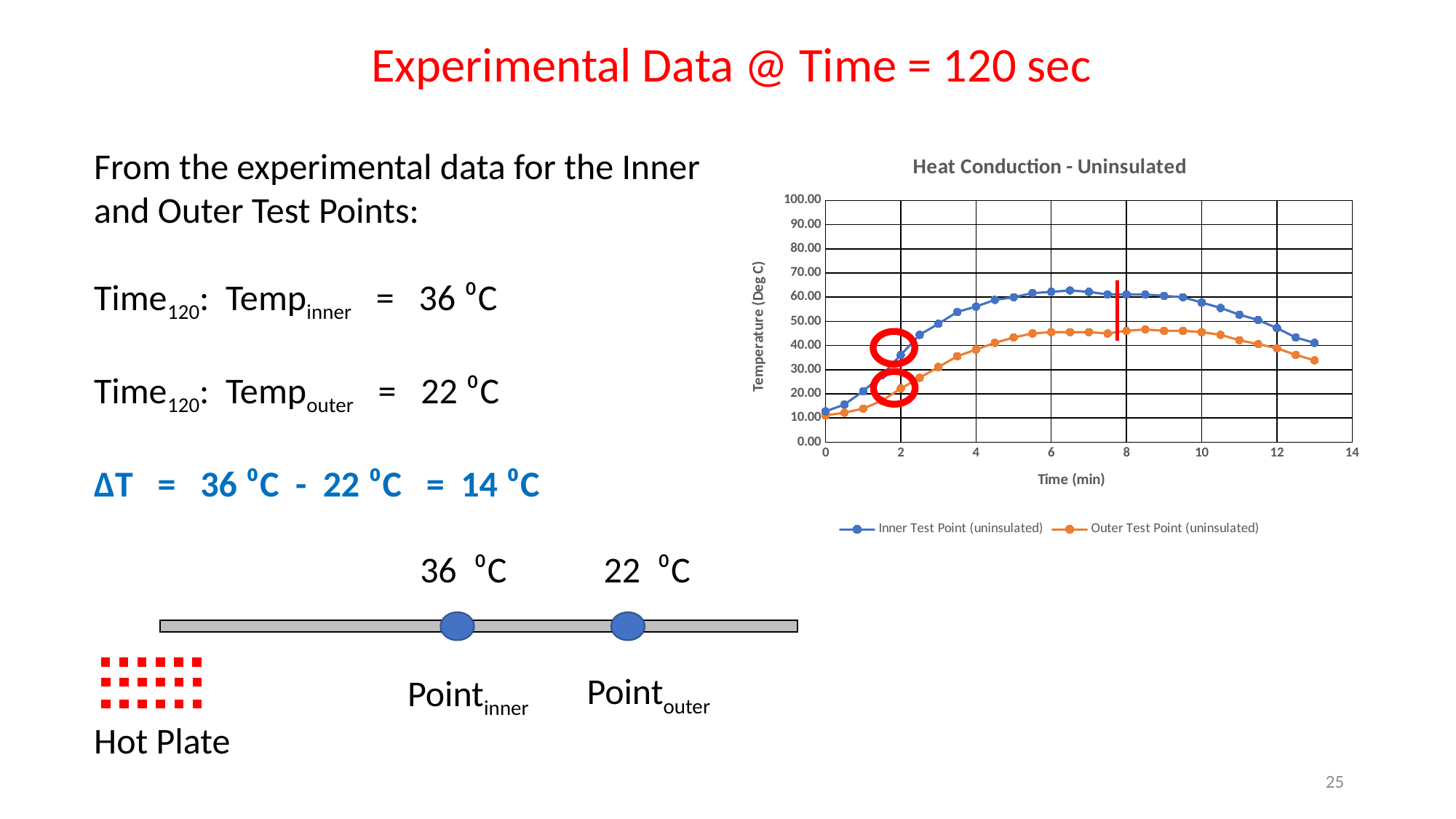
At 6 min, which series has the higher temperature, Inner Test Point (uninsulated) or Outer Test Point (uninsulated)? Inner Test Point (uninsulated) What is the difference between the inner and outer test point temperatures at time 120 sec? 14 °C Is the value for the Outer Test Point (uninsulated) at 6 min greater or less than 50.00? less What is the title of the chart? Heat Conduction - Uninsulated Is the value for the Outer Test Point (uninsulated) at 13 min greater or less than 40.00? less According to the slide, what is the inner test point temperature at time 120 sec? 36 °C Does the Inner Test Point (uninsulated) series rise or fall between 0 and 4 min? rise What kind of chart is shown on the slide? line chart According to the slide, what is the outer test point temperature at time 120 sec? 22 °C How many series does the chart legend list? 2 Is the value for the Inner Test Point (uninsulated) at 6 min greater or less than 50.00? greater What is the label of the chart's x axis? Time (min)